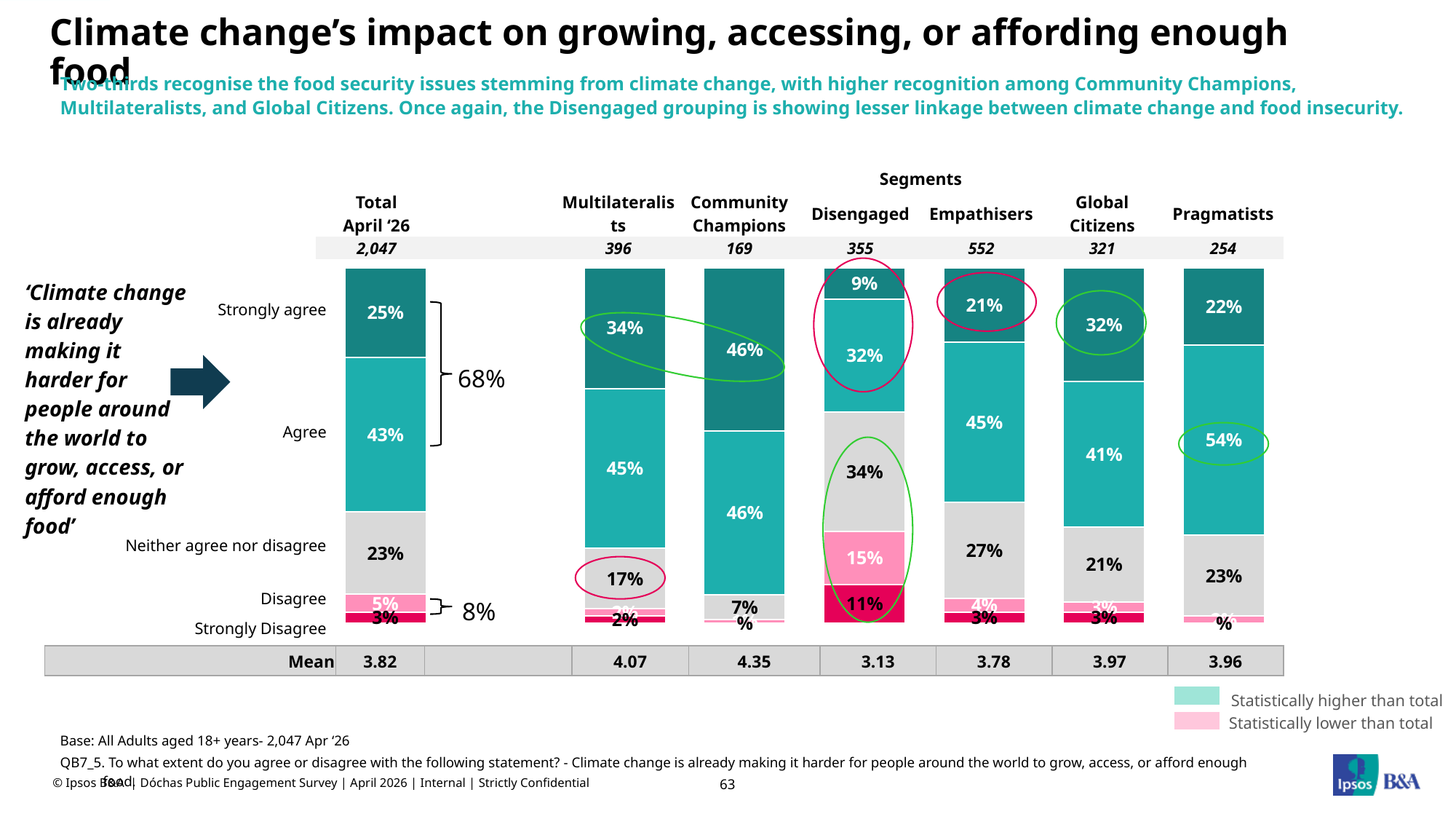
What is the mean score for the Disengaged segment? 3.13 What is the combined 'Strongly agree' plus 'Agree' percentage shown for the Total April '26 bar? 68% What percentage of the Total April '26 group strongly agree that climate change is already making it harder for people to grow, access, or afford enough food? 25% What percentage of the Disengaged segment neither agree nor disagree? 34% What type of chart is used on this slide? Stacked bar chart How many stacked bars are shown in the chart, including the Total bar? 7 Which is larger: the 'Neither agree nor disagree' share for Multilateralists or for Empathisers? Empathisers What is the difference between the 'Strongly agree' percentages for Community Champions and Empathisers? 25% Which segment has the highest 'Agree' percentage? Pragmatists Which segment has the highest mean score? Community Champions What percentage of Community Champions strongly agree with the statement? 46% Which segment has the lowest 'Strongly agree' percentage? Disengaged